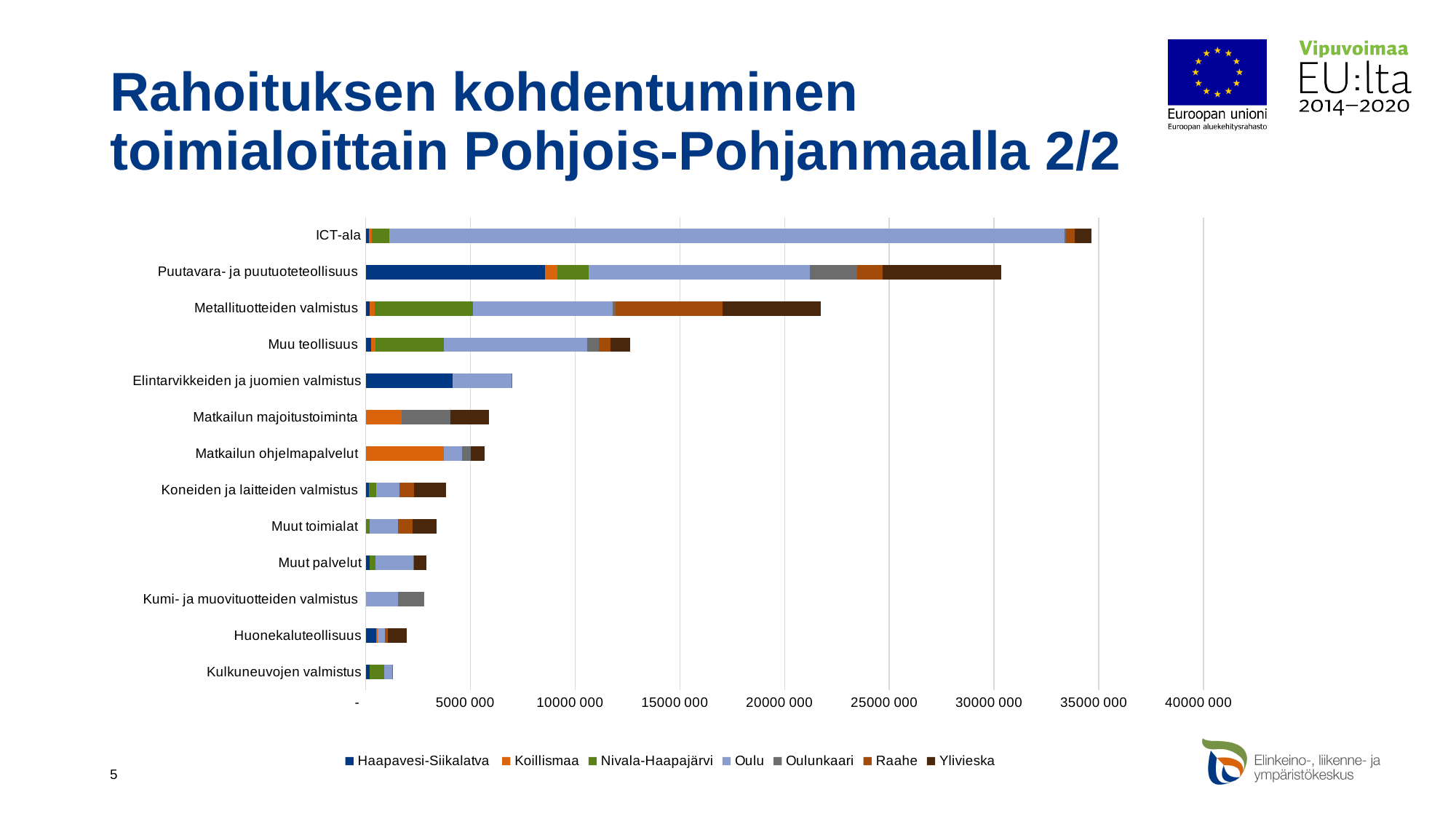
Which region is shown in orange in the legend? Koillismaa How many industry categories are plotted on the chart? 13 Is the total bar for Muu teollisuus greater or less than 10000 000? greater Which industry has the longest total bar? ICT-ala What kind of chart is shown on the slide? Stacked bar chart Is the total bar for Kulkuneuvojen valmistus greater or less than 5000 000? less Which industry has the shortest total bar? Kulkuneuvojen valmistus Which region accounts for the largest segment of the ICT-ala bar? Oulu How many series does the legend list? 7 Is the total bar for ICT-ala greater or less than 30000 000? greater Which has the longer total bar, Metallituotteiden valmistus or Muu teollisuus? Metallituotteiden valmistus